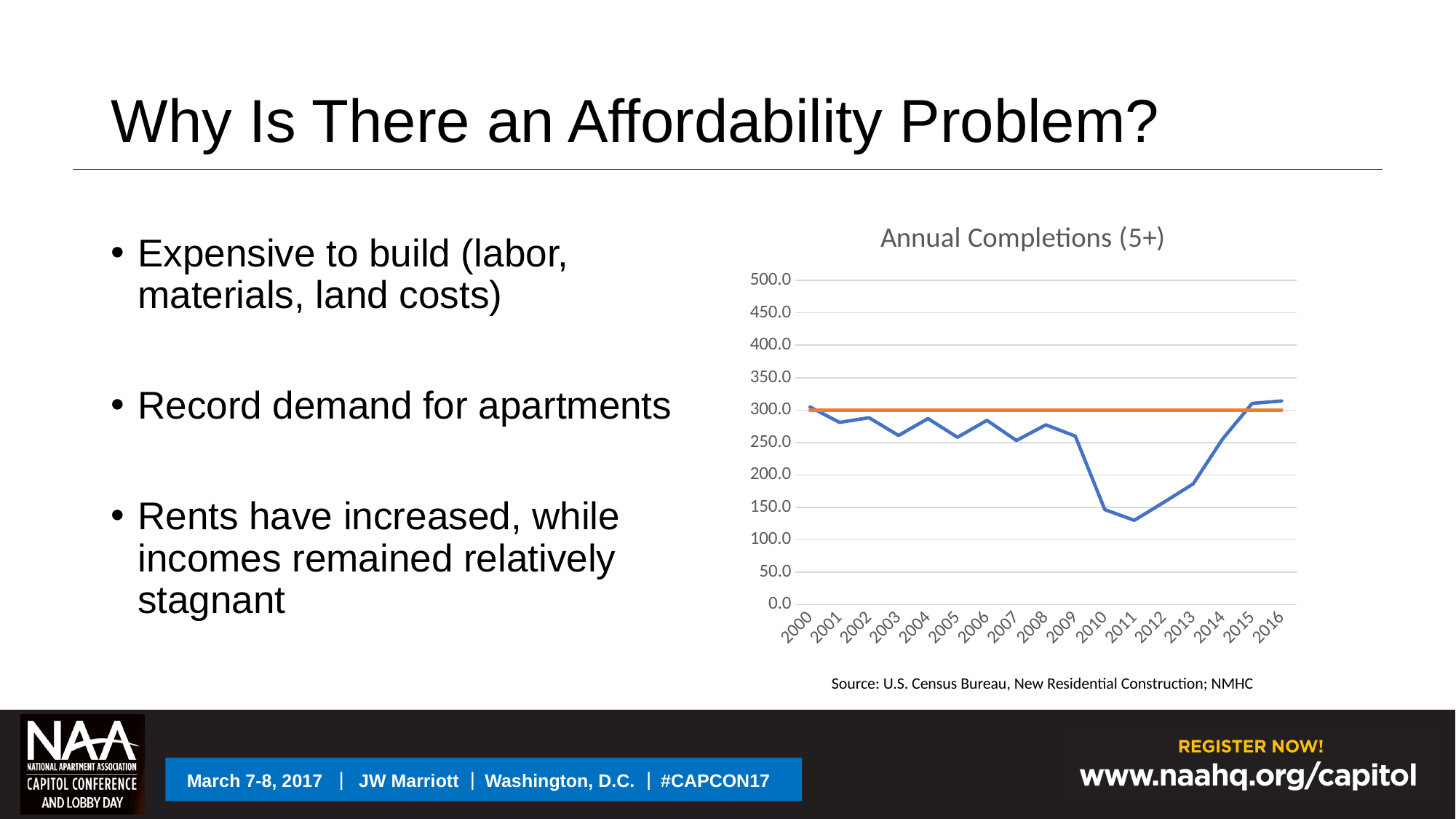
Which year has the lowest value on the blue line? 2011 Which year has the larger value, 2011 or 2016? 2016 What kind of chart is shown on the slide? line chart Is the value for 2011 greater or less than 150? less How many years are plotted along the x axis of the chart? 17 Do the values on the blue line rise or fall from 2009 to 2011? fall Is the value for 2005 greater or less than 300? less Is the value for 2010 greater or less than 200? less What is the title of the chart? Annual Completions (5+) Do the values on the blue line rise or fall from 2011 to 2016? rise